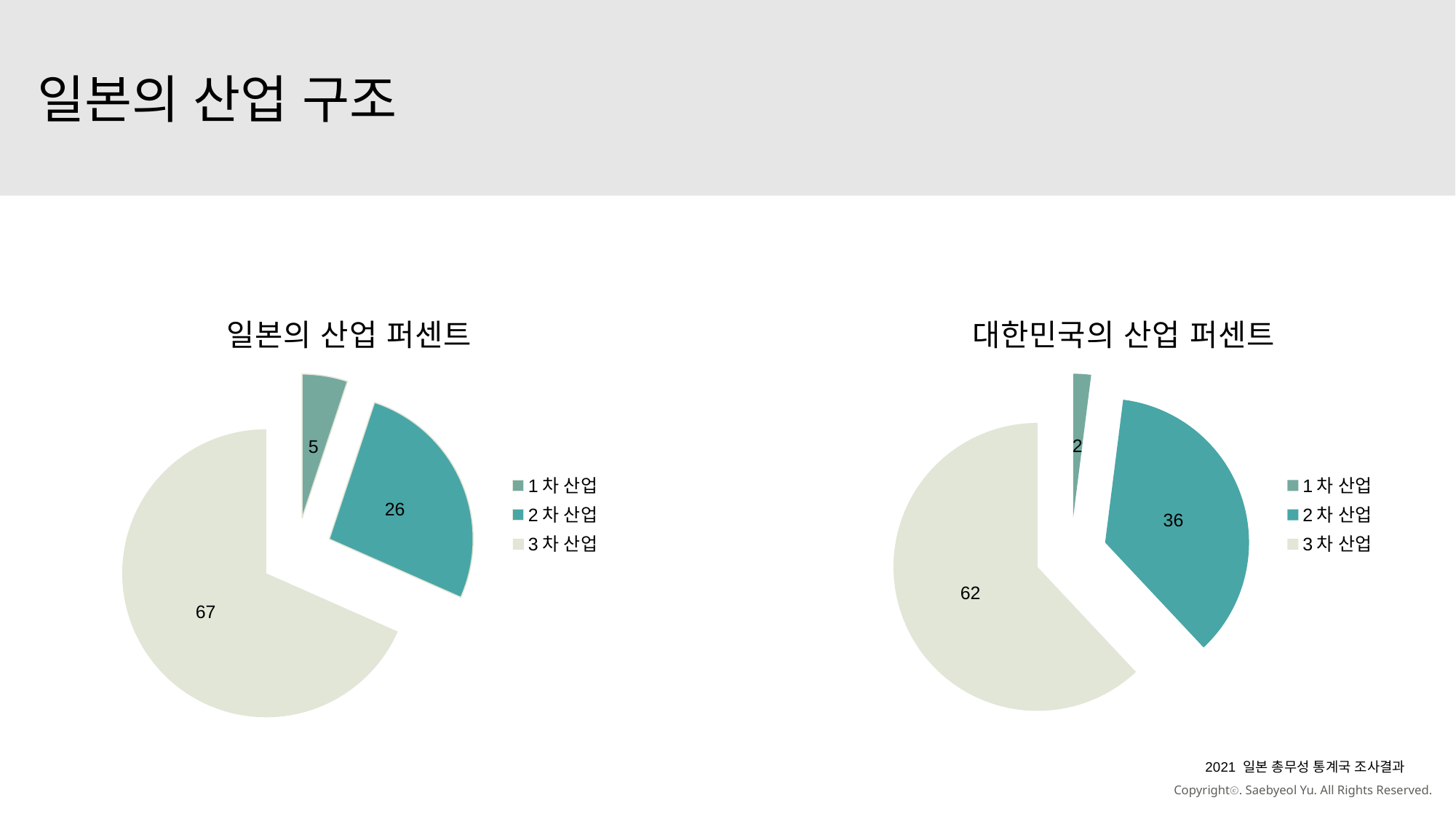
In the chart titled 일본의 산업 퍼센트, what is the difference between the values for 3 차 산업 and 2 차 산업? 41 In the chart titled 대한민국의 산업 퍼센트, which category has the smallest slice? 1 차 산업 How many categories does the legend of the chart titled 일본의 산업 퍼센트 list? 3 In the chart titled 대한민국의 산업 퍼센트, what is the difference between the values for 2 차 산업 and 1 차 산업? 34 In the chart titled 일본의 산업 퍼센트, what is the value for 3 차 산업? 67 In the chart titled 일본의 산업 퍼센트, what is the value for 1 차 산업? 5 In the chart titled 대한민국의 산업 퍼센트, what share of the pie does 3 차 산업 represent? 62% In the chart titled 대한민국의 산업 퍼센트, what is the value for 2 차 산업? 36 In the chart titled 대한민국의 산업 퍼센트, what is the value for 1 차 산업? 2 What type of chart is the chart titled 대한민국의 산업 퍼센트? Pie chart In the chart titled 일본의 산업 퍼센트, which category has the largest slice? 3 차 산업 Which is larger: the value for 2 차 산업 in the chart titled 일본의 산업 퍼센트 or the value for 2 차 산업 in the chart titled 대한민국의 산업 퍼센트? 대한민국의 산업 퍼센트